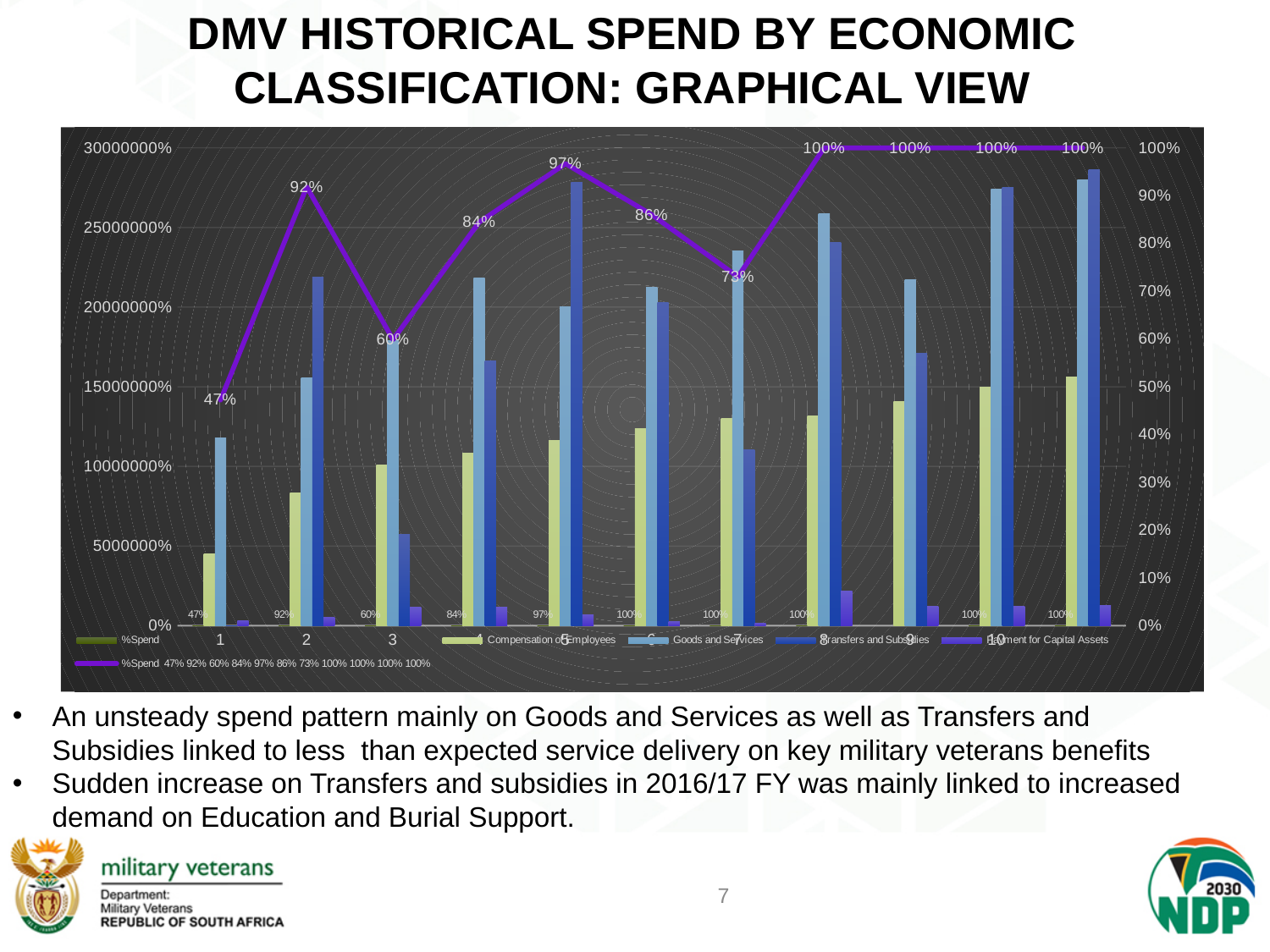
How many series does the legend list? 6 What is the %Spend value for category 5? 97% What is the title of the slide containing the chart? DMV HISTORICAL SPEND BY ECONOMIC CLASSIFICATION: GRAPHICAL VIEW What kind of chart is shown on the slide? Combination bar and line chart What is the %Spend value for category 1? 47% Which category has the lowest %Spend value? 1 (47%) How many categories are shown on the x axis? 11 What is the %Spend value for category 3? 60% Does the %Spend line rise or fall from category 7 to category 8? Rise What is the difference between the %Spend values for categories 2 and 3? 32 percentage points Which is larger, the %Spend value for category 4 or for category 6? Category 6 (86%) Is the Goods and Services bar for category 2 greater or less than 20000000%? less